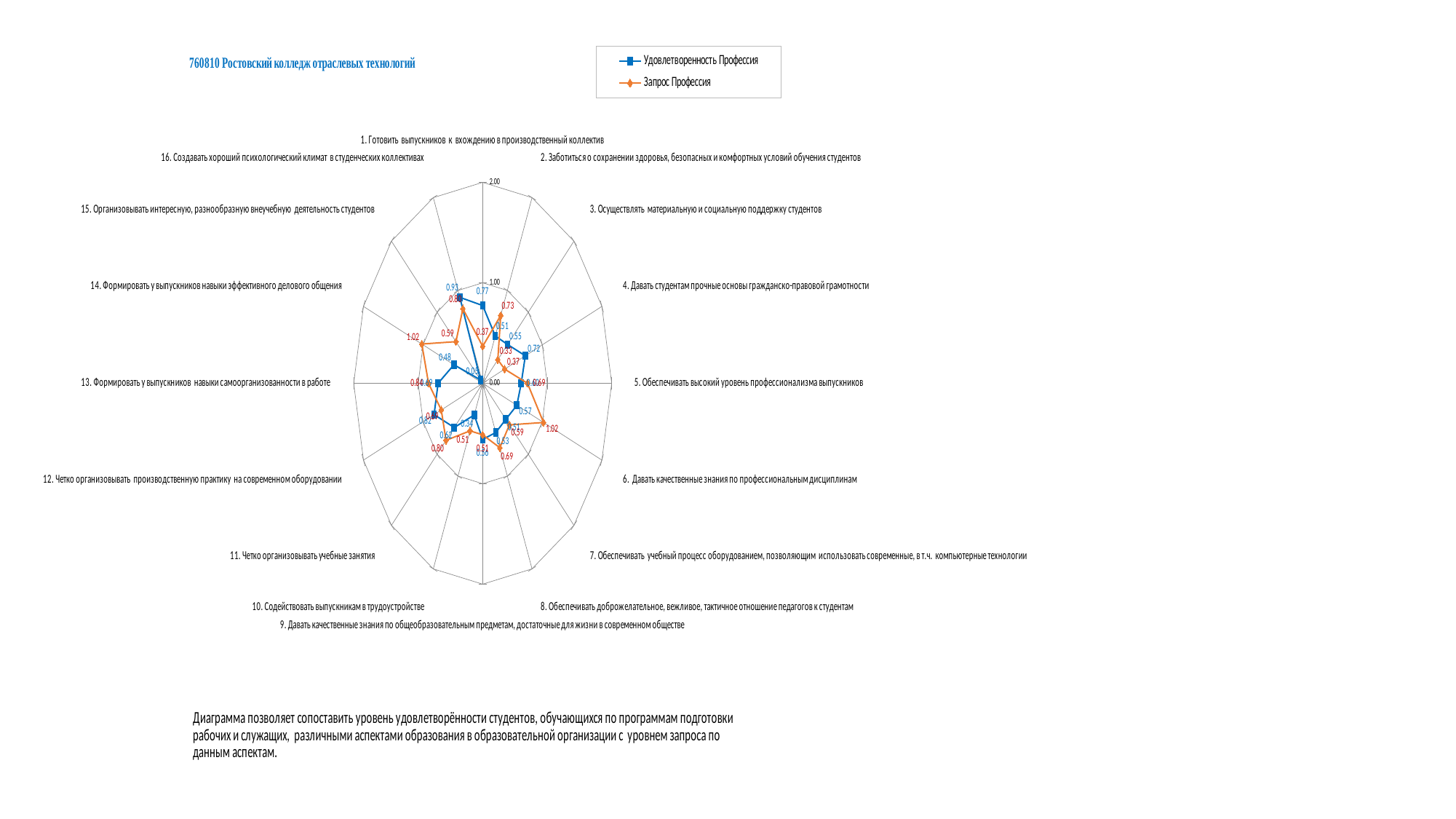
What is the 'Удовлетворенность Профессия' value for category 1 (Готовить выпускников к вхождению в производственный коллектив)? 0.77 What is the difference between the 'Запрос Профессия' and 'Удовлетворенность Профессия' values for category 6? 0.45 Which category has the highest 'Удовлетворенность Профессия' value? 16. Создавать хороший психологический климат в студенческих коллективах Is the 'Удовлетворенность Профессия' value for category 16 greater or less than 1.00? less For category 6, which series has the larger value: 'Удовлетворенность Профессия' or 'Запрос Профессия'? Запрос Профессия What is the 'Удовлетворенность Профессия' value for category 16 (Создавать хороший психологический климат в студенческих коллективах)? 0.93 How many categories (aspects) are plotted on the radar chart? 16 What is the 'Запрос Профессия' value for category 2 (Заботиться о сохранении здоровья, безопасных и комфортных условий обучения студентов)? 0.73 How many series does the legend list? 2 What is the 'Запрос Профессия' value for category 6 (Давать качественные знания по профессиональным дисциплинам)? 1.02 What is the maximum value shown on the radial axis of the chart? 2.00 What kind of chart is shown on the slide? Radar chart